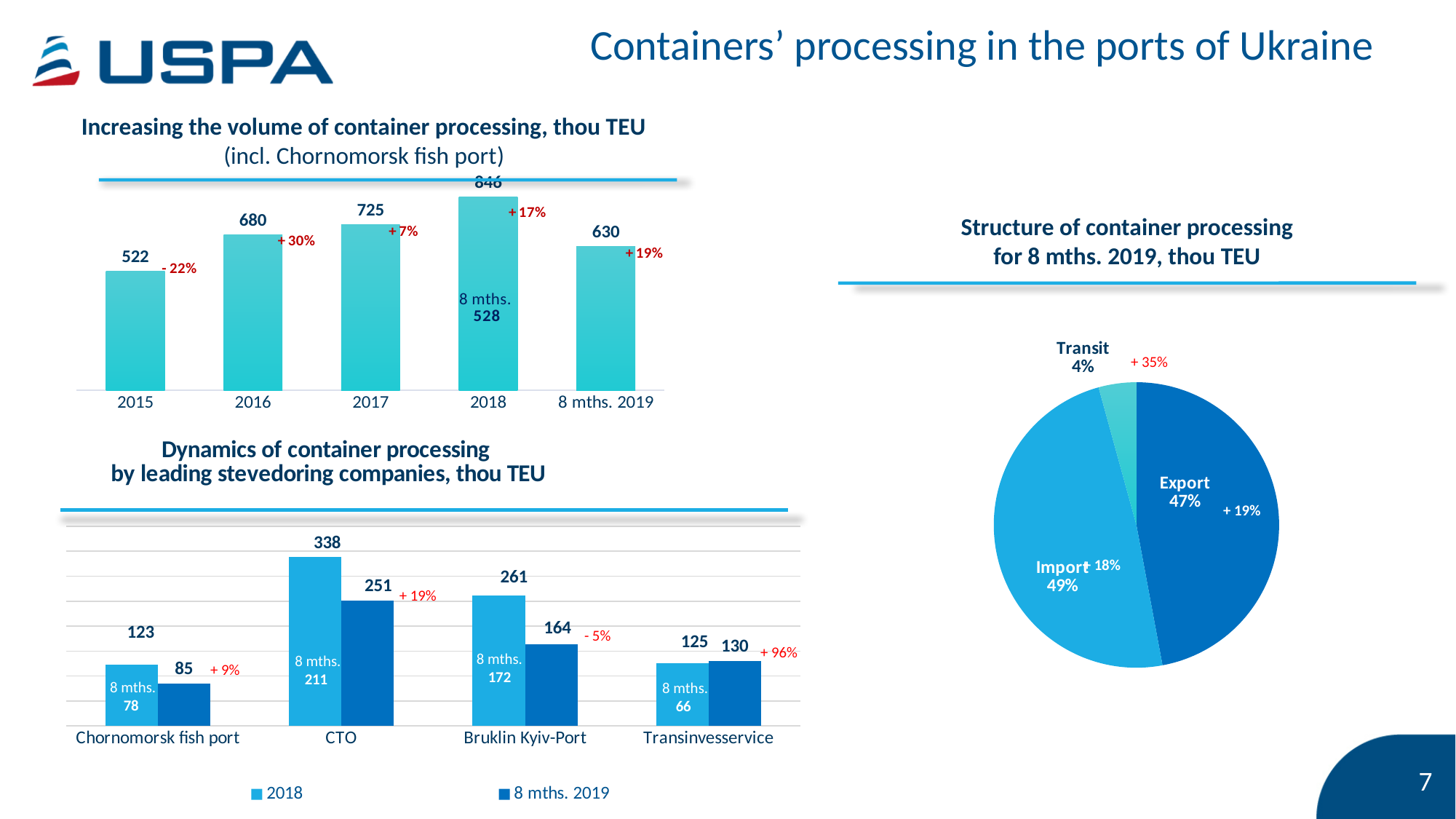
In the pie chart 'Structure of container processing for 8 mths. 2019, thou TEU', what share does Import have? 49% In the chart 'Dynamics of container processing by leading stevedoring companies, thou TEU', how many companies are shown on the x axis? 4 In the chart 'Increasing the volume of container processing, thou TEU', what is the value for 8 mths. 2019? 630 In the chart 'Dynamics of container processing by leading stevedoring companies, thou TEU', what is the 2018 value for CTO? 338 In the chart 'Dynamics of container processing by leading stevedoring companies, thou TEU', which company has the highest 2018 value? CTO In the chart 'Dynamics of container processing by leading stevedoring companies, thou TEU', how many series does the legend list? 2 In the chart 'Increasing the volume of container processing, thou TEU', what is the difference between the 2017 and 2016 values? 45 In the chart 'Increasing the volume of container processing, thou TEU', which year has the lowest value? 2015 In the pie chart 'Structure of container processing for 8 mths. 2019, thou TEU', which category has the smallest slice? Transit In the chart 'Dynamics of container processing by leading stevedoring companies, thou TEU', what is the 8 mths. 2019 value for Bruklin Kyiv-Port? 164 In the chart 'Increasing the volume of container processing, thou TEU', what is the value for 2015? 522 In the chart 'Increasing the volume of container processing, thou TEU', what percentage change is shown next to the 2016 bar? + 30%